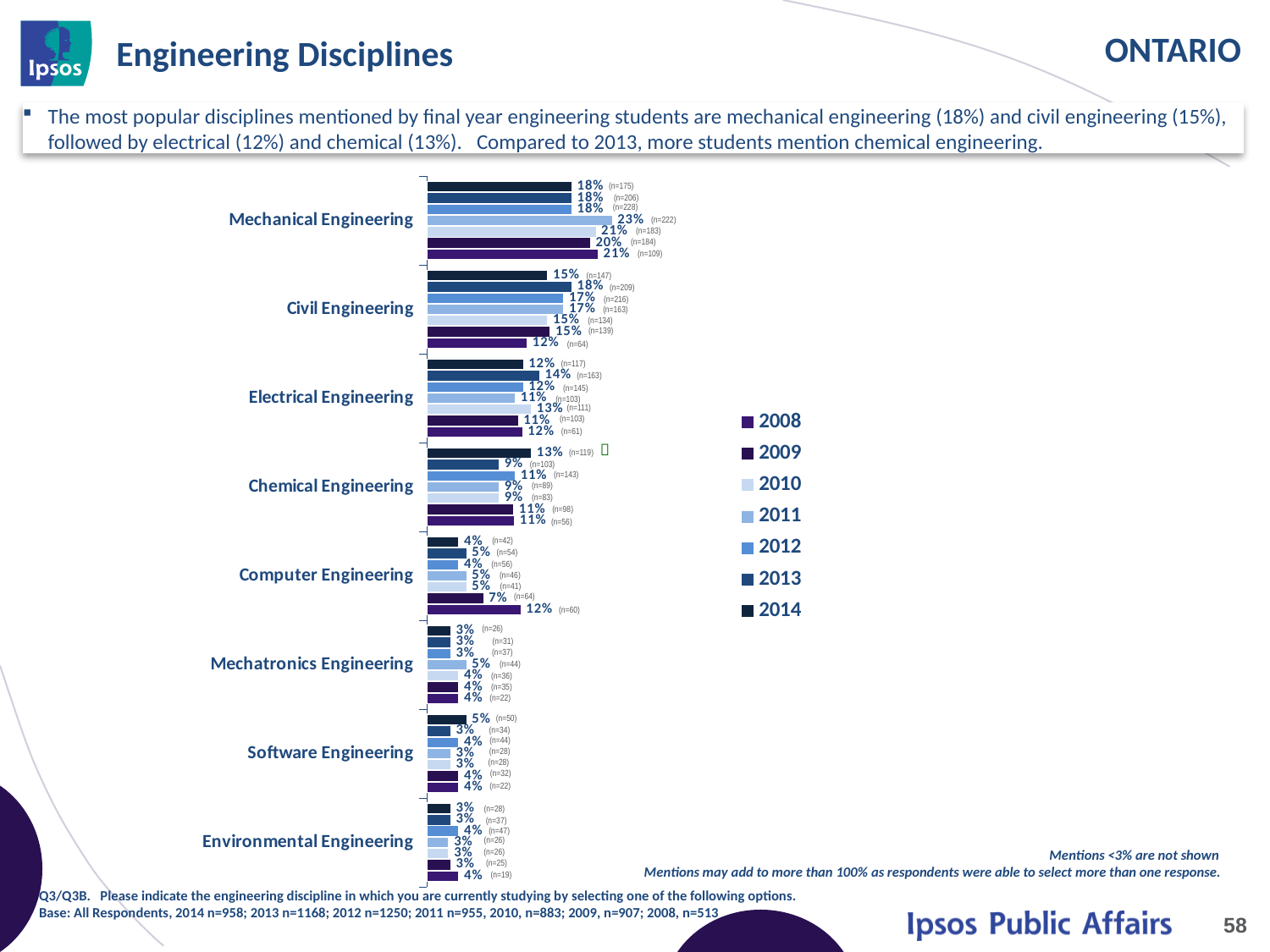
What is the difference between the 2014 values for Mechanical Engineering and Civil Engineering? 3 percentage points What is the 2014 value for Mechanical Engineering? 18% What is the 2014 value for Civil Engineering? 15% How many series does the legend list? 7 Which year is listed first in the legend? 2008 What kind of chart is shown on the slide? bar chart What is the largest value shown among the Mechanical Engineering bars? 23% Which discipline has the highest 2014 value? Mechanical Engineering In 2014, which is larger: Chemical Engineering or Electrical Engineering? Chemical Engineering What is the 2014 value for Chemical Engineering? 13% How many engineering disciplines are shown as categories on the chart? 8 According to the note on the chart, mentions below what percentage are not shown? 3%